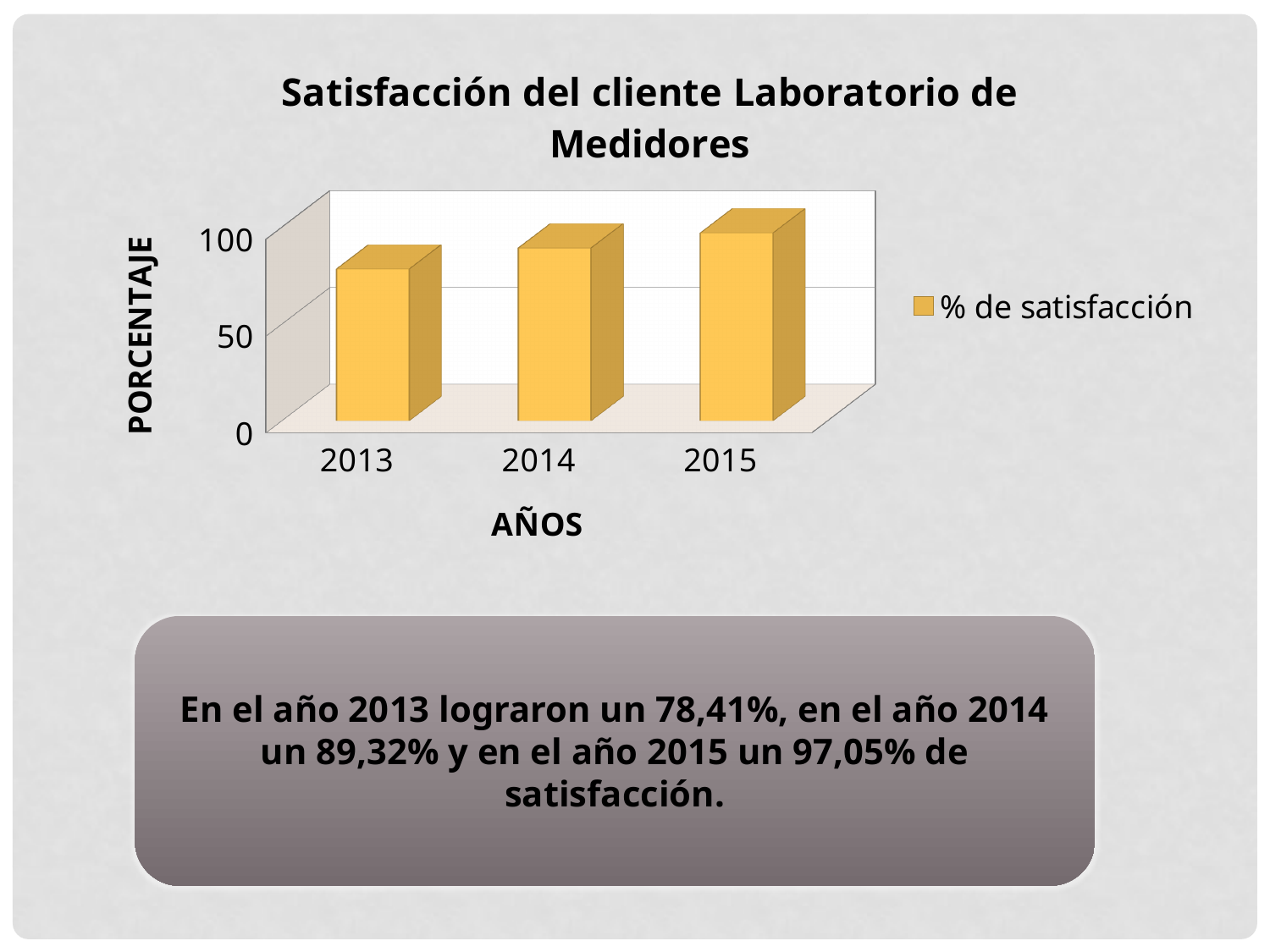
Which year has the lowest % de satisfacción? 2013 According to the slide, what was the % de satisfacción in 2014? 89,32% How many series does the chart legend list? 1 Which year has the highest % de satisfacción? 2015 How many years (categories) are plotted on the x axis of the chart? 3 Is the value for 2013 greater or less than 100? less According to the slide, what was the % de satisfacción in 2015? 97,05% Do the satisfaction values rise or fall from 2013 to 2015? Rise Which is larger, the satisfaction value for 2014 or for 2015? 2015 What is the label of the series shown in the chart legend? % de satisfacción What type of chart is shown on the slide? Bar chart Is the value for 2013 greater or less than 50? greater